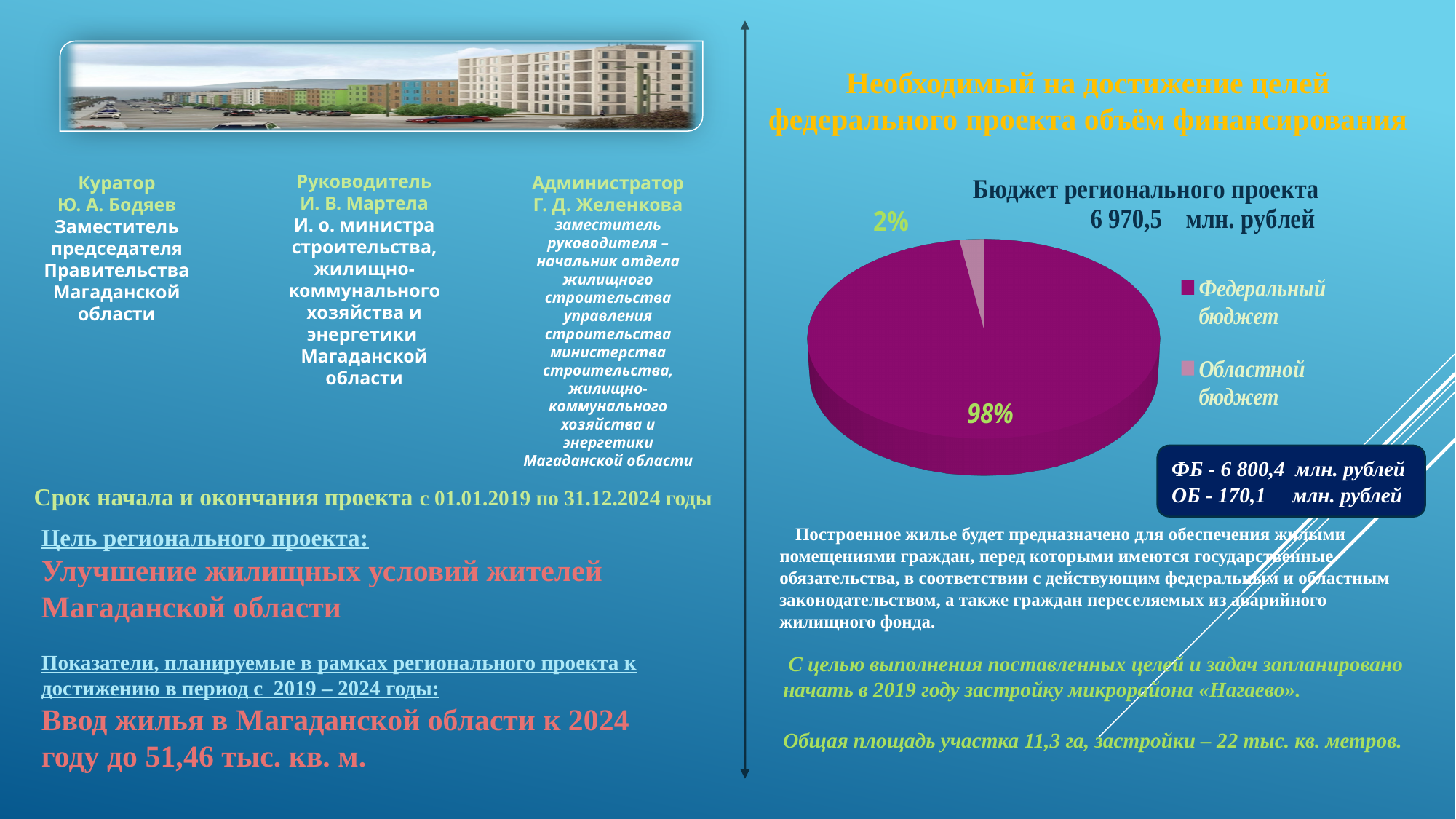
Which slice of the pie chart is the smallest? Областной бюджет Which slice of the pie chart is the largest? Федеральный бюджет What is the title of the pie chart? Бюджет регионального проекта 6 970,5 млн. рублей Which is larger in the pie chart, Федеральный бюджет or Областной бюджет? Федеральный бюджет What share of the pie does Областной бюджет have? 2% What share of the pie does Федеральный бюджет have? 98% By how many percentage points does the Федеральный бюджет share exceed the Областной бюджет share? 96 How many slices does the pie chart have? 2 How many entries does the legend of the pie chart list? 2 What colour is the Федеральный бюджет slice in the pie chart? magenta (dark purple-pink) What kind of chart is shown on the slide? pie chart